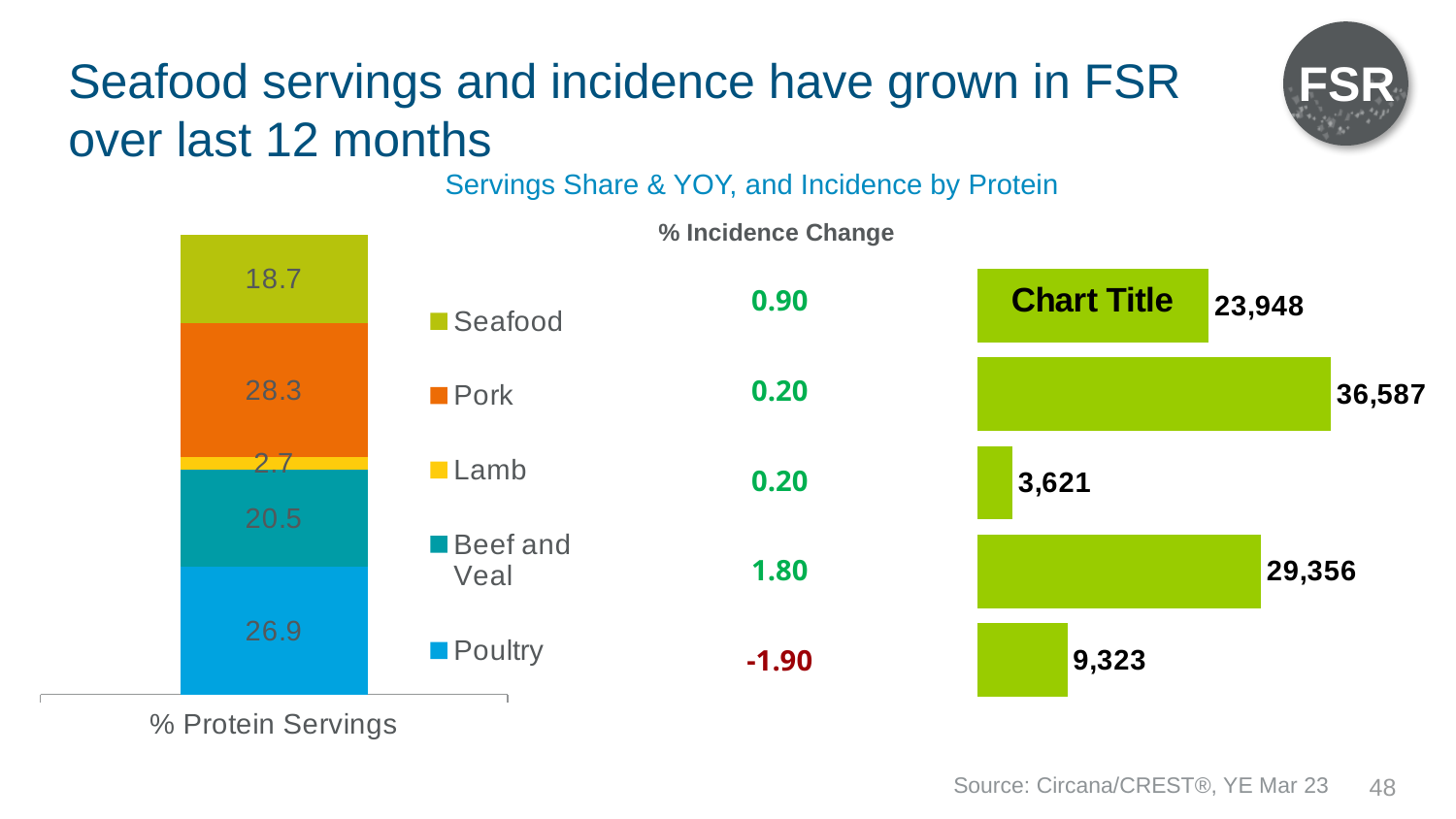
What kind of chart is the chart on the right of the slide titled 'Chart Title'? Bar chart In the bar chart on the right titled 'Chart Title', what is the value of the bottom bar? 9,323 In the stacked bar chart labelled '% Protein Servings', which is larger, Seafood or Beef and Veal? Beef and Veal In the stacked bar chart labelled '% Protein Servings', which protein has the smallest share? Lamb In the stacked bar chart labelled '% Protein Servings', what is the value for Lamb? 2.7 In the bar chart on the right titled 'Chart Title', how many bars are there? 5 In the stacked bar chart labelled '% Protein Servings', what is the value for Seafood? 18.7 In the stacked bar chart labelled '% Protein Servings', what is the difference between the Poultry and Beef and Veal values? 6.4 How many entries does the legend of the stacked bar chart list? 5 In the bar chart on the right titled 'Chart Title', what is the value of the second bar from the top? 36,587 In the stacked bar chart labelled '% Protein Servings', what is the value for Pork? 28.3 In the stacked bar chart labelled '% Protein Servings', which protein has the largest share? Pork